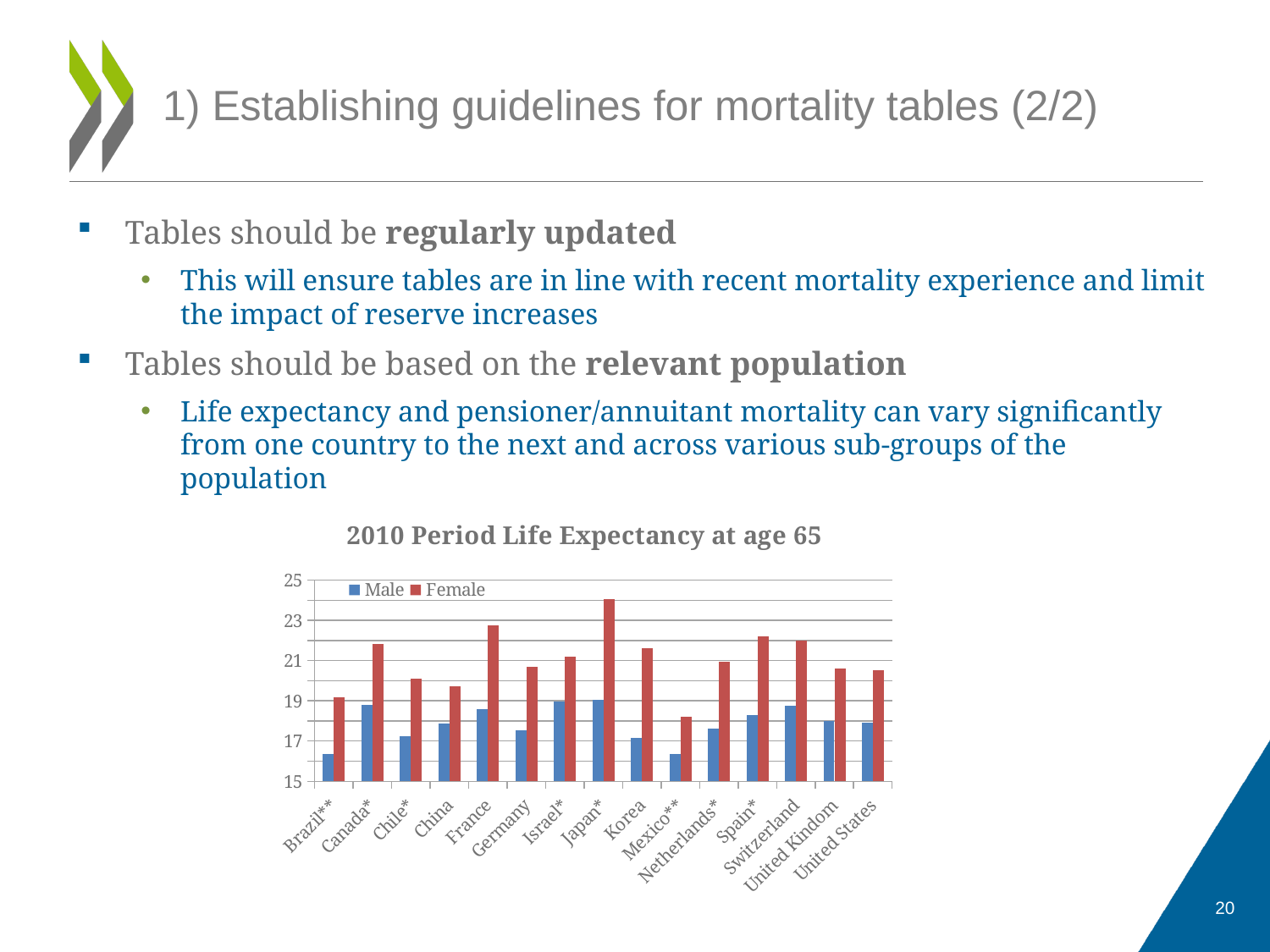
How many countries are shown on the x axis of the chart? 15 Which country has the highest Female life expectancy at age 65? Japan* Which country has the lowest Female life expectancy at age 65? Mexico** Is the Female value for France greater or less than 21? greater Is the Female value for Japan* greater or less than 23? greater Is the Female value for Mexico** greater or less than 19? less Which is larger, the Male value for Canada* or the Male value for Chile*? Canada* What type of chart is shown on the slide? bar chart Which is larger, the Female value for Japan* or the Female value for Korea? Japan* What is the title of the chart? 2010 Period Life Expectancy at age 65 How many series does the chart's legend list? 2